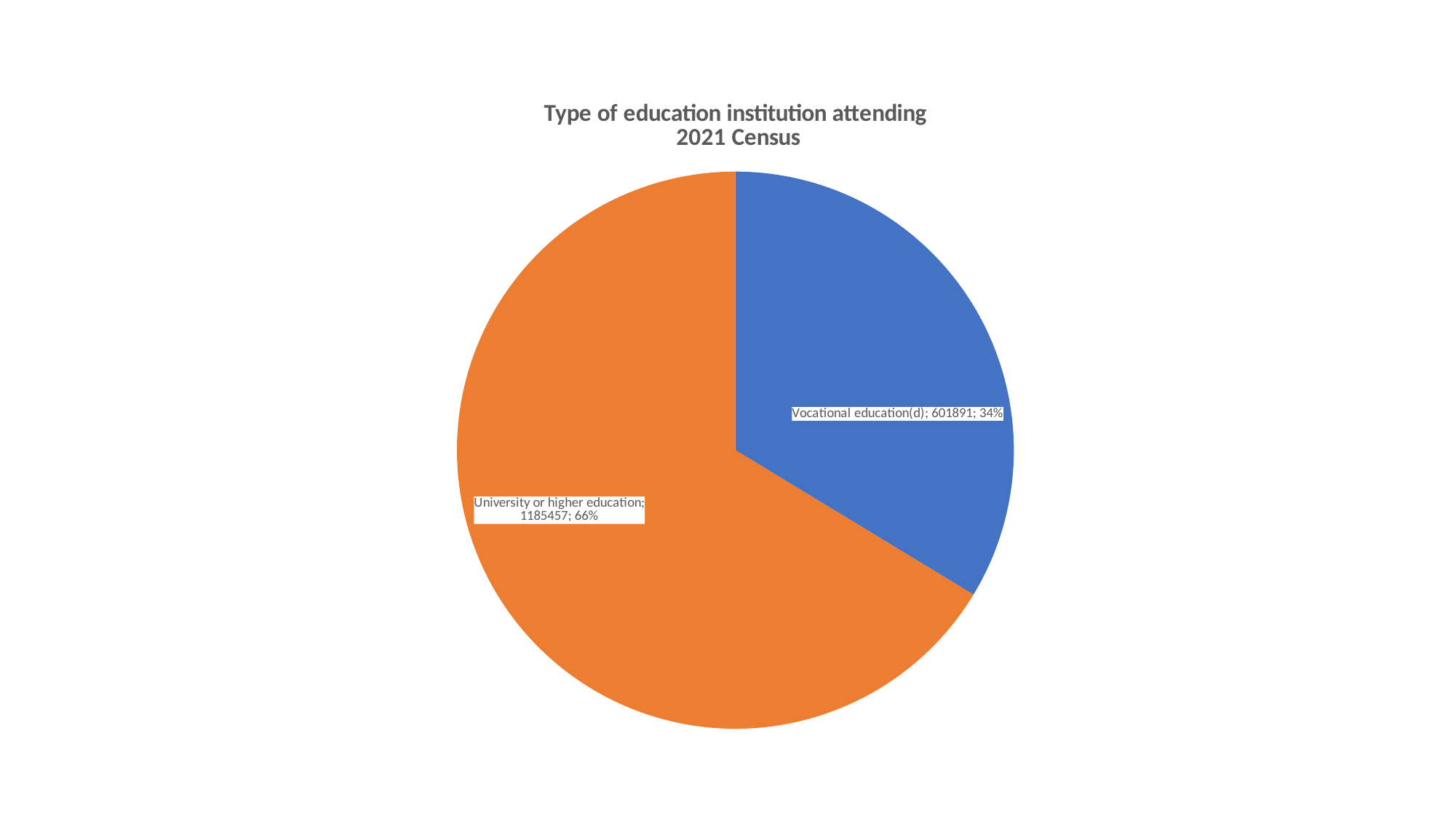
Which is larger, University or higher education or Vocational education(d)? University or higher education What is the value for University or higher education? 1185457 What colour is the slice for Vocational education(d)? blue What is the difference between the values for University or higher education and Vocational education(d)? 583566 What is the value for Vocational education(d)? 601891 What kind of chart is shown on the slide? pie chart Which category has the largest slice? University or higher education What share of the pie does University or higher education represent? 66% What share of the pie does Vocational education(d) represent? 34% What is the title of the chart? Type of education institution attending 2021 Census How many slices does the pie chart have? 2 Which category has the smallest slice? Vocational education(d)